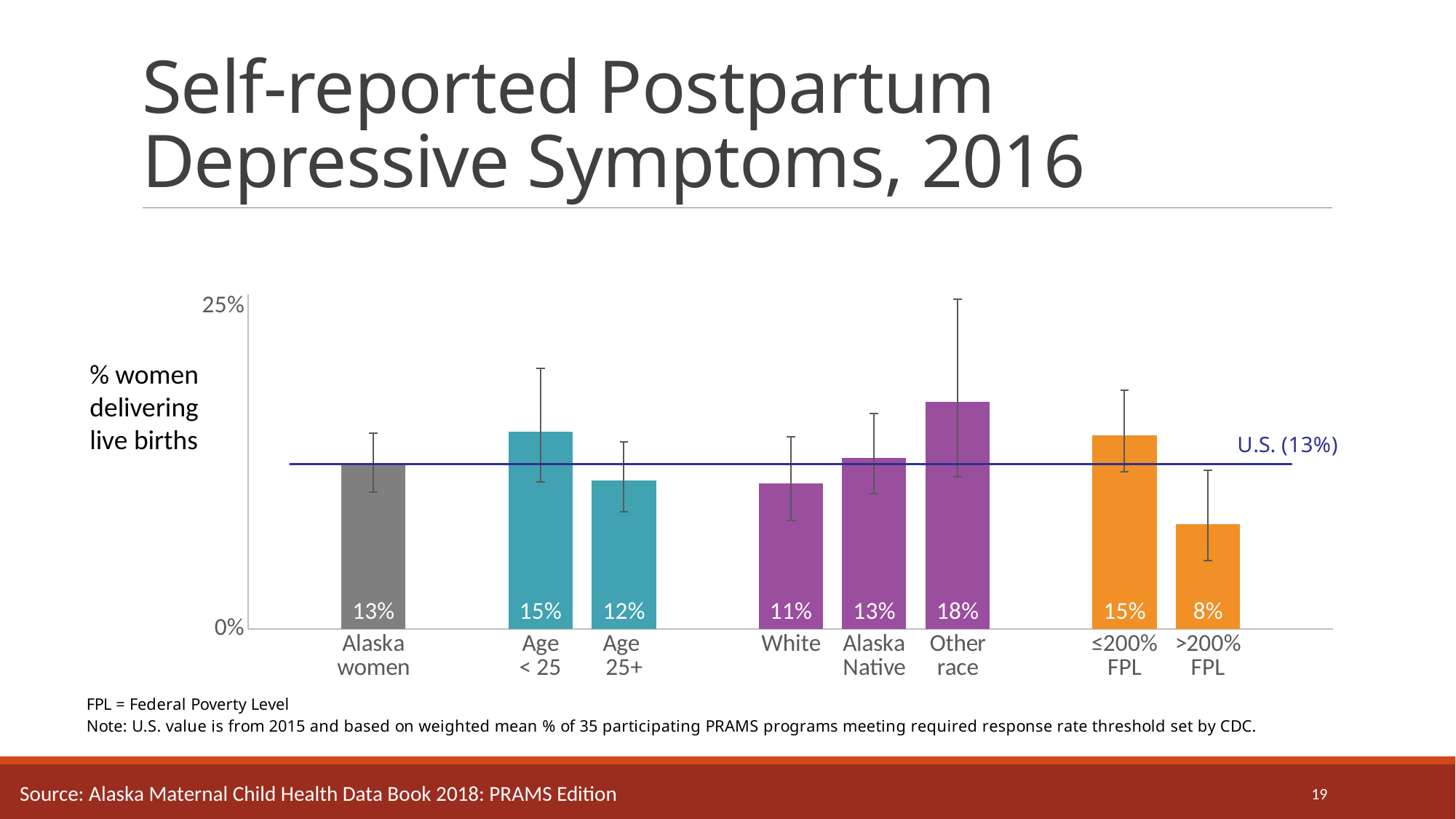
What is the value for Alaska women? 13% What is the value for >200% FPL? 8% What U.S. value is marked by the horizontal reference line? 13% What is the value for Age < 25? 15% Which category has the lowest value? >200% FPL What is the difference between the values for ≤200% FPL and >200% FPL? 7% What kind of chart is this? Bar chart What is the difference between the values for Age < 25 and Age 25+? 3% Which is larger, the value for White or the value for Alaska Native? Alaska Native How many bars are shown in the chart? 8 Which category has the highest value? Other race What is the label on the y axis? % women delivering live births